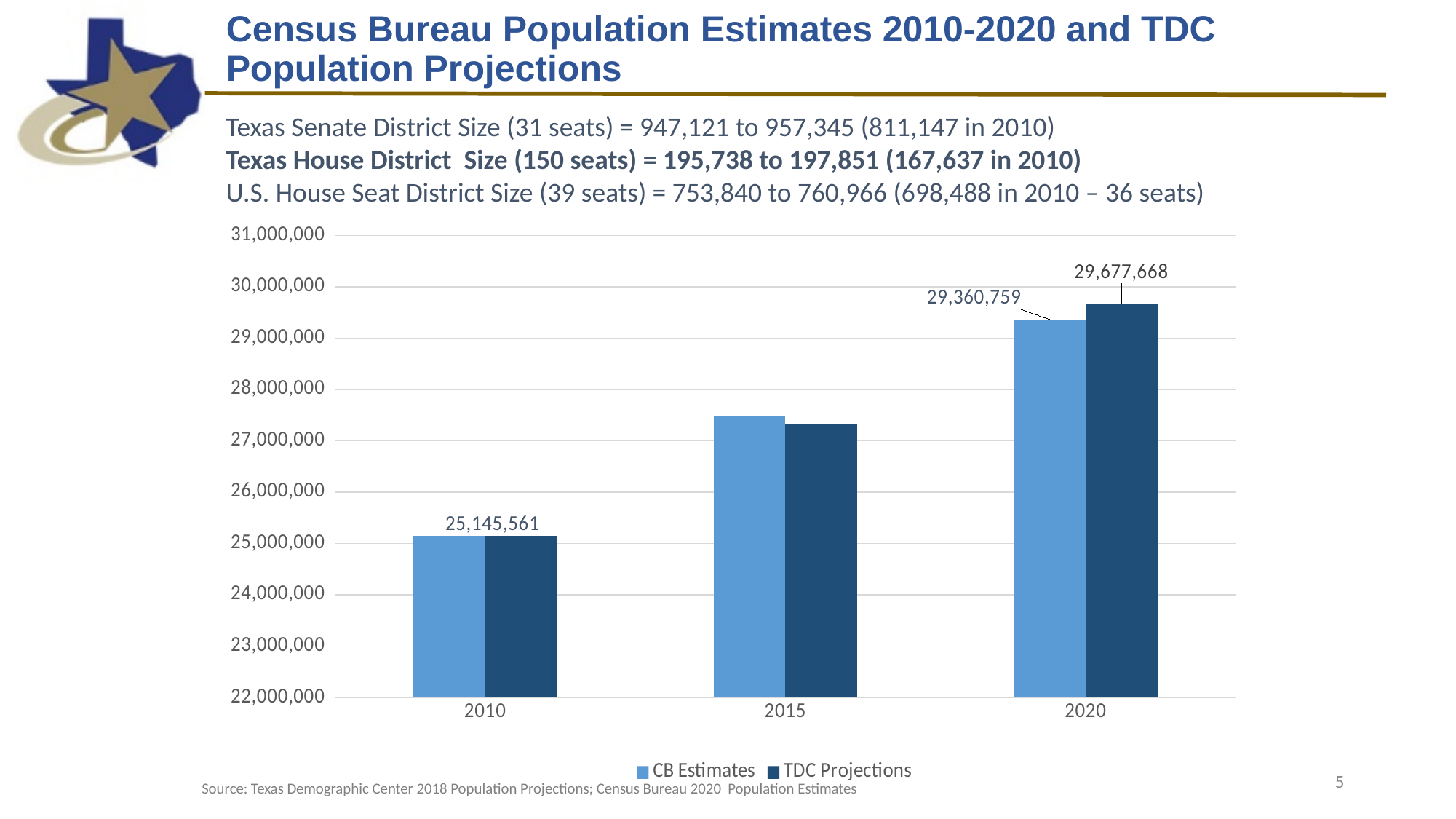
How many series does the chart legend list? 2 What is the CB Estimates value for 2020? 29,360,759 What kind of chart is shown on the slide? bar chart What is the difference between the TDC Projections and CB Estimates values for 2020? 316,909 How many years are shown on the x axis of the chart? 3 For 2020, which is larger: CB Estimates or TDC Projections? TDC Projections What population value is labelled for 2010? 25,145,561 Do the population values rise or fall from 2010 to 2020? rise Is the TDC Projections value for 2015 greater or less than 28,000,000? less Which series and year has the highest bar in the chart? TDC Projections, 2020 Is the CB Estimates value for 2015 greater or less than 27,000,000? greater What is the TDC Projections value for 2020? 29,677,668